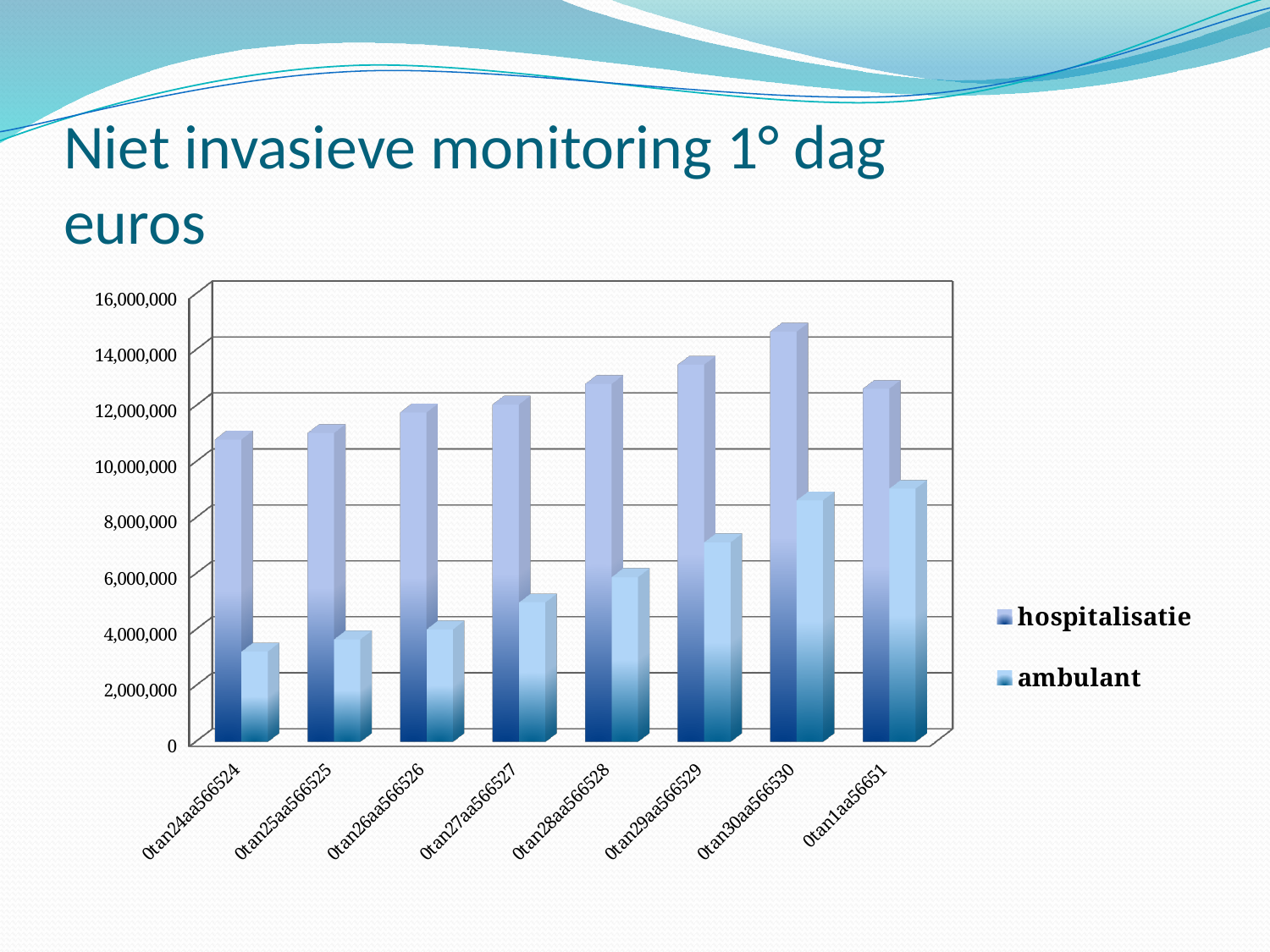
What are the two entries in the chart legend? hospitalisatie and ambulant Is the hospitalisatie value for 0tan24aa566524 greater or less than 10,000,000? greater Which category has the highest hospitalisatie value? 0tan30aa566530 How many series does the legend list? 2 Is the ambulant value for 0tan29aa566529 greater or less than 6,000,000? greater For 0tan28aa566528, which is larger: hospitalisatie or ambulant? hospitalisatie Is the ambulant value for 0tan24aa566524 greater or less than 4,000,000? less Which category has the lowest ambulant value? 0tan24aa566524 Do the ambulant values rise or fall from left to right along the x axis? rise How many categories are shown on the x axis? 8 What kind of chart is shown on the slide? bar chart